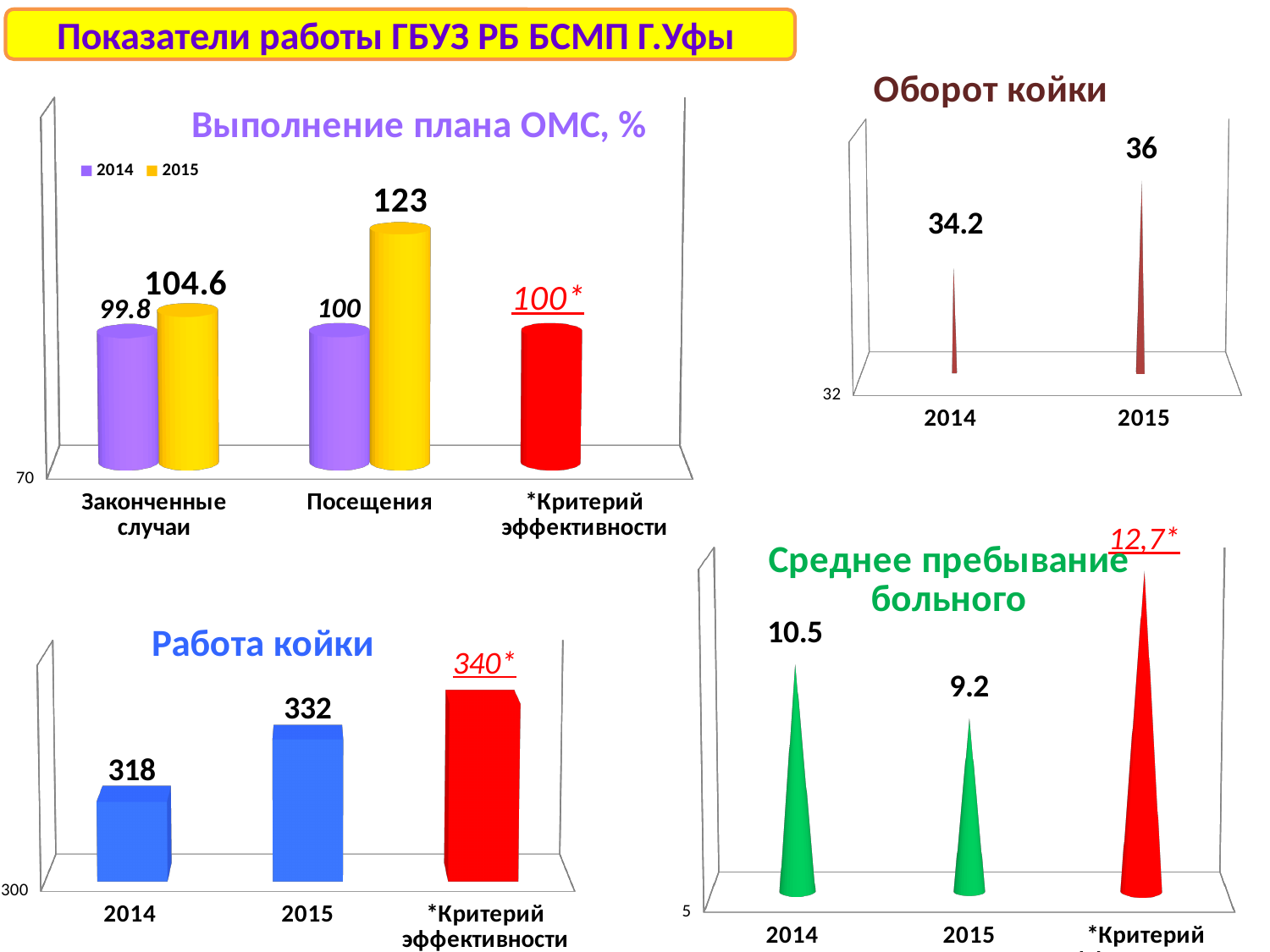
In the chart 'Работа койки', what is the value for 2014? 318 In the chart 'Оборот койки', do the values rise or fall from 2014 to 2015? rise In the chart 'Работа койки', what is the difference between the 2015 value and the 2014 value? 14 In the chart 'Среднее пребывание больного', what is the value for 2015? 9.2 In the chart 'Оборот койки', what is the value for 2015? 36 In the chart 'Оборот койки', which year has the higher value? 2015 In the chart 'Выполнение плана ОМС, %', what is the 2014 value for Законченные случаи? 99.8 In the chart 'Выполнение плана ОМС, %', what is the 2015 value for Посещения? 123 In the chart 'Среднее пребывание больного', which category has the lowest value? 2015 In the chart 'Среднее пребывание больного', how many categories are shown on the x axis? 3 In the chart 'Выполнение плана ОМС, %', what is the difference between the 2015 and 2014 values for Законченные случаи? 4.8 In the chart 'Выполнение плана ОМС, %', how many series does the legend list? 2